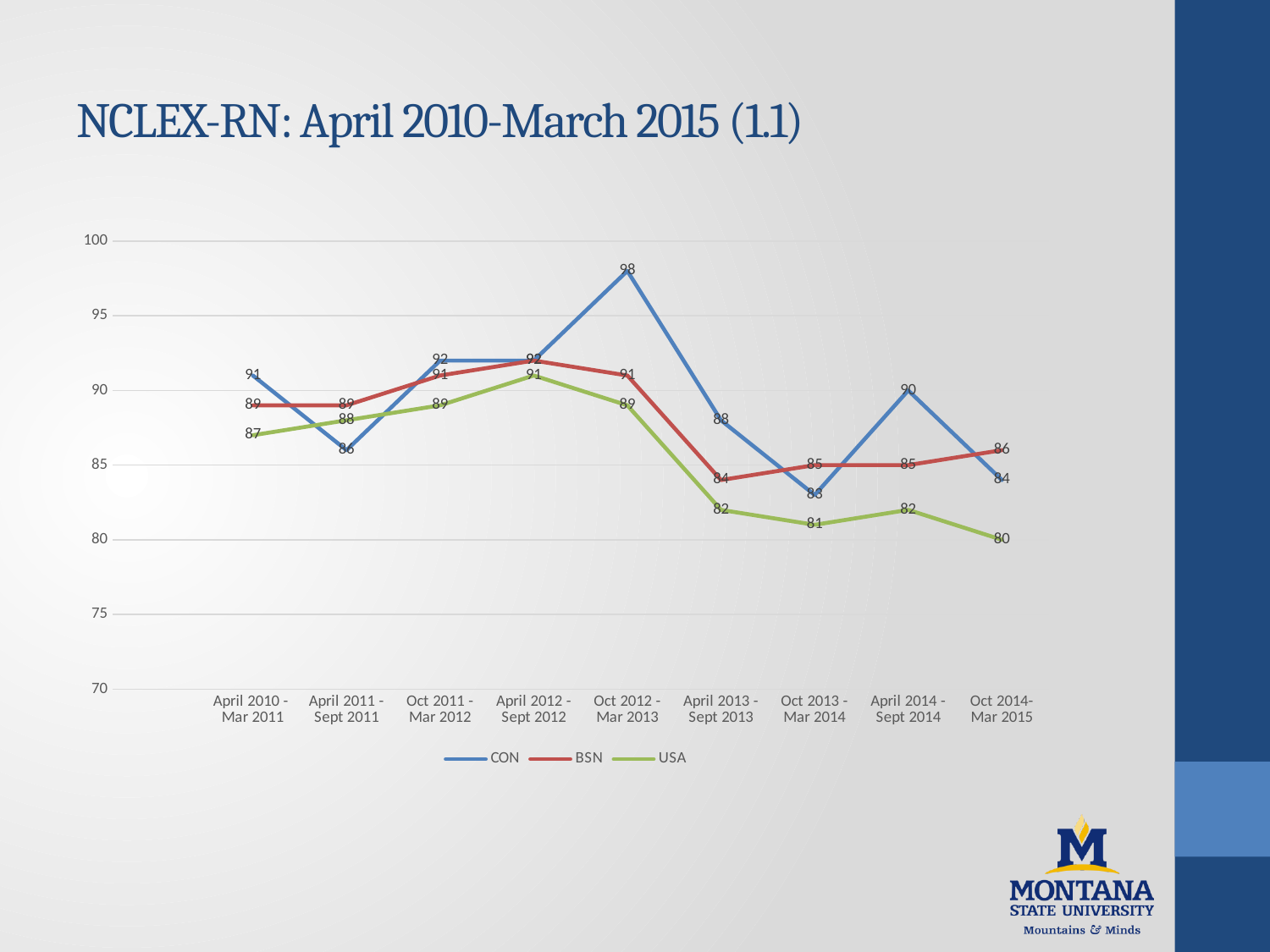
What is the difference between the CON and USA values for Oct 2012 - Mar 2013? 9 What is the CON value for Oct 2012 - Mar 2013? 98 How many series does the legend list? 3 How many time periods are plotted along the x axis? 9 Which series has the higher value for Oct 2013 - Mar 2014, CON or BSN? BSN Does the USA series rise or fall from April 2012 - Sept 2012 to Oct 2014 - Mar 2015? Fall What is the BSN value for April 2013 - Sept 2013? 84 In which period does the USA series reach its lowest value? Oct 2014 - Mar 2015 What type of chart is shown on the slide? Line chart What is the title of the chart? NCLEX-RN: April 2010-March 2015 (1.1) In which period does the CON series reach its highest value? Oct 2012 - Mar 2013 What is the USA value for Oct 2014 - Mar 2015? 80